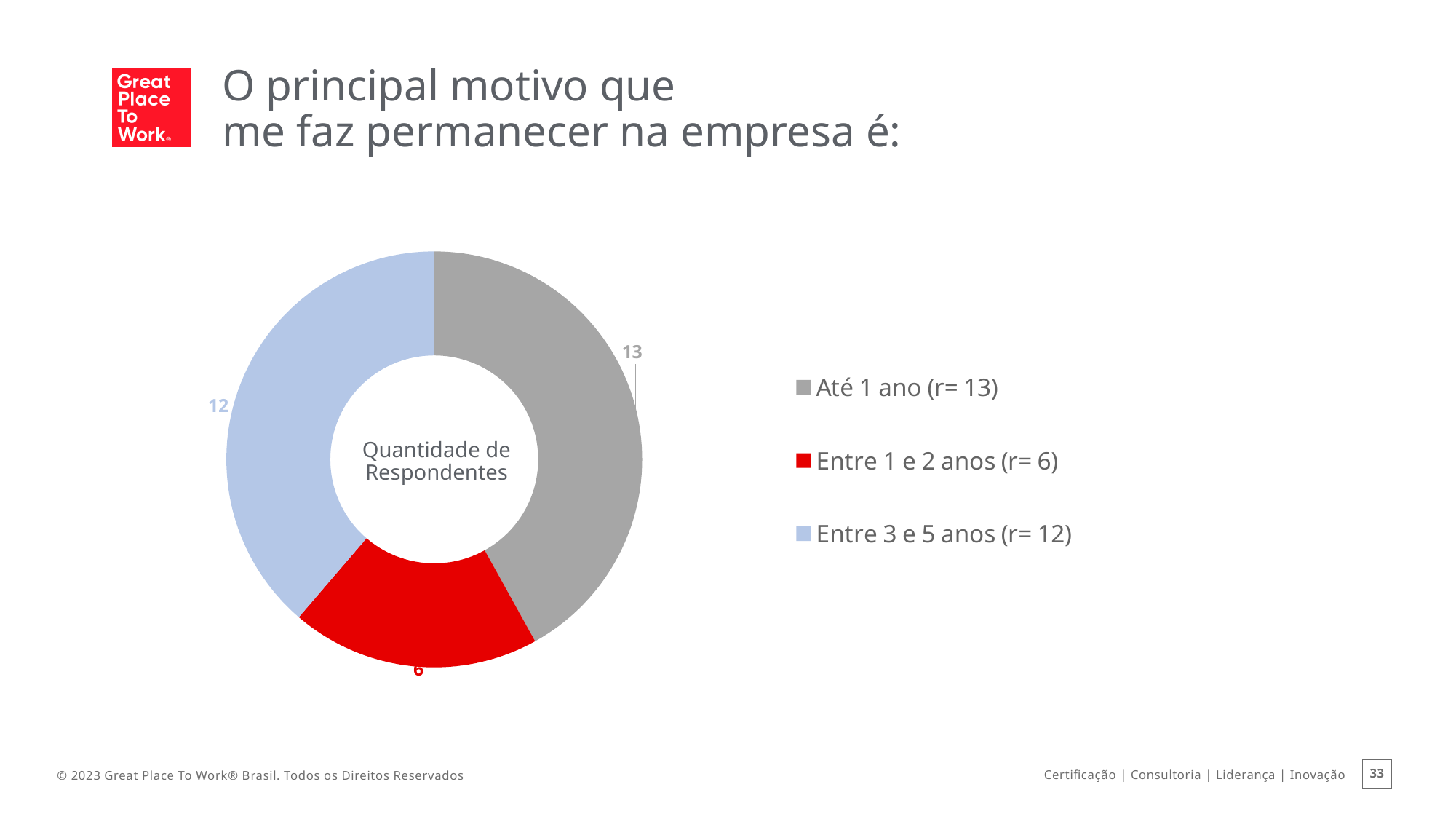
How many respondents are in the 'Entre 1 e 2 anos' category? 6 What is the difference in respondents between 'Entre 3 e 5 anos' and 'Entre 1 e 2 anos'? 6 Which category has the fewest respondents? Entre 1 e 2 anos What is the difference in respondents between 'Até 1 ano' and 'Entre 1 e 2 anos'? 7 How many respondents are in the 'Entre 3 e 5 anos' category? 12 How many categories does the chart show? 3 How many respondents are in the 'Até 1 ano' category? 13 What colour is the 'Entre 1 e 2 anos' slice? Red Which has more respondents, 'Até 1 ano' or 'Entre 3 e 5 anos'? Até 1 ano Which category has the most respondents? Até 1 ano What kind of chart is shown on the slide? Doughnut chart What is the total number of respondents across all categories? 31